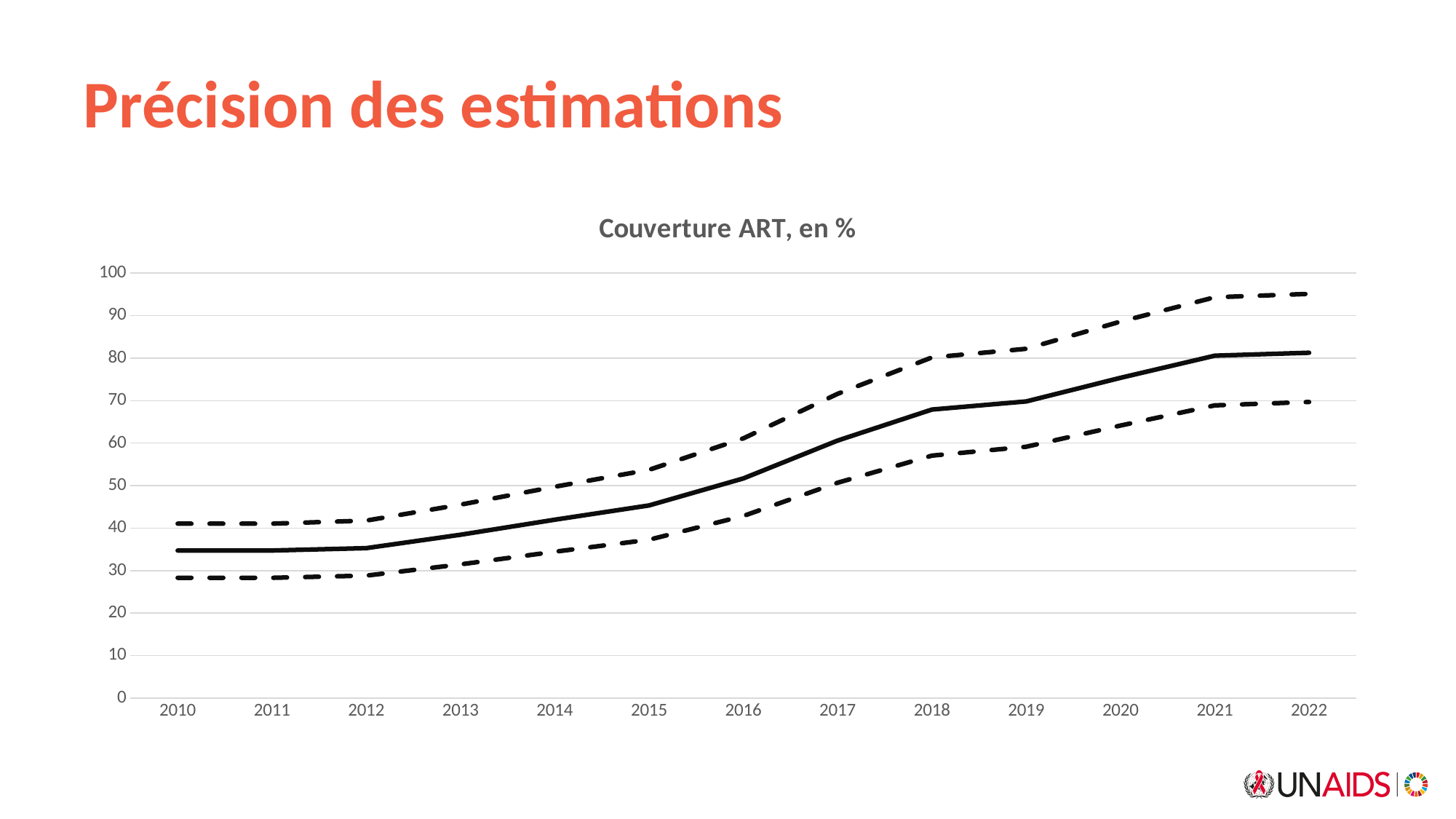
How many years are shown on the x axis of the chart? 13 Is the value of the solid line for 2022 greater or less than 70? greater What kind of chart is shown on the slide? line chart Is the value of the lower dashed line for 2010 greater or less than 30? less How many lines are plotted on the chart? 3 Is the value of the upper dashed line for 2022 greater or less than 90? greater What is the title of the chart? Couverture ART, en % Which is larger for the solid line: the value for 2010 or the value for 2022? 2022 Does the solid line rise or fall from 2010 to 2022? rise